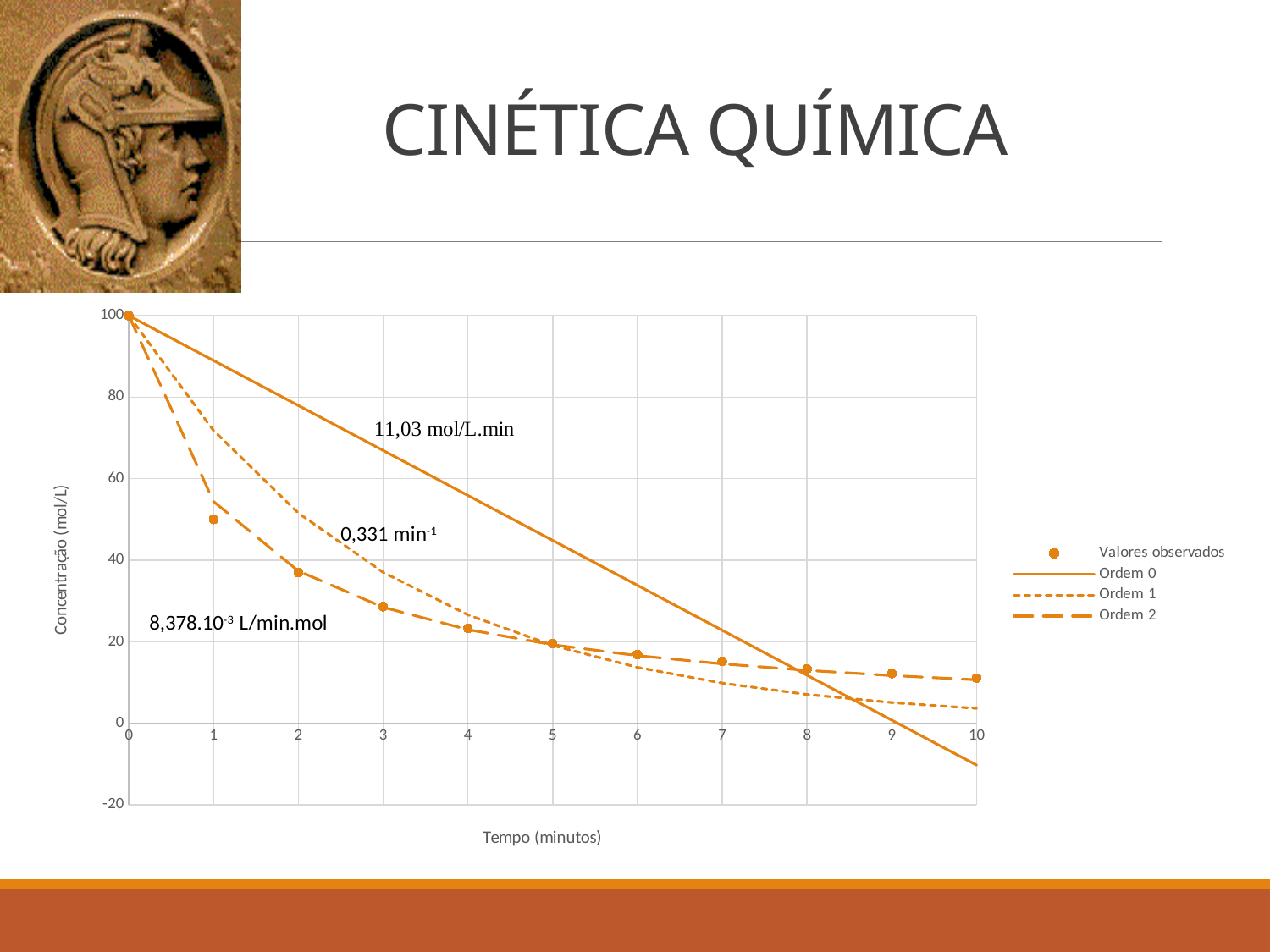
Do the observed values rise or fall as time increases? fall At which time (in minutes) is the observed concentration highest? 0 What is the observed concentration at time 0 minutes? 100 How many observed data points (Valores observados) are plotted? 11 What kind of chart is shown on the slide? line chart What is the title of the x axis? Tempo (minutos) How many series does the legend list? 4 At which time (in minutes) is the observed concentration lowest? 10 Is the observed value at 6 minutes greater or less than 20? less Is the Ordem 0 line at 10 minutes greater or less than 0? less Is the observed value at 1 minute greater or less than 40? greater Which is larger: the observed value at 1 minute or at 3 minutes? 1 minute